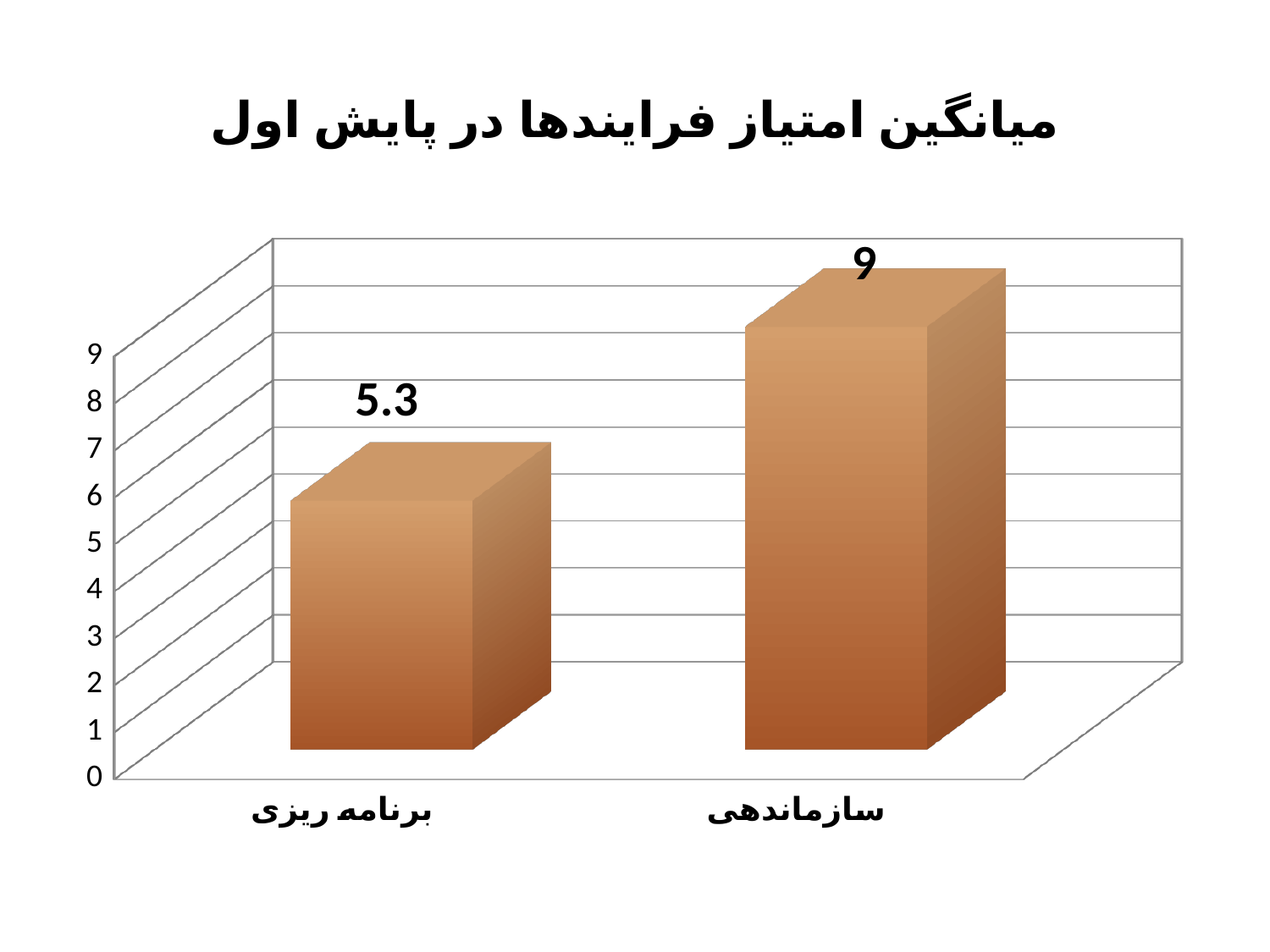
What is the value for برنامه ریزی? 5.3 Is the value for برنامه ریزی greater or less than 6? less What is the highest value shown on the vertical axis? 9 What is the value for سازماندهی? 9 Is the value for سازماندهی greater or less than 8? greater What is the title of the chart? میانگین امتیاز فرایندها در پایش اول What kind of chart is shown on the slide? bar chart Which category has the highest value? سازماندهی How many categories are shown in the chart? 2 Which category has the lowest value? برنامه ریزی What is the difference between the values for سازماندهی and برنامه ریزی? 3.7 Which is larger, the value for برنامه ریزی or the value for سازماندهی? سازماندهی